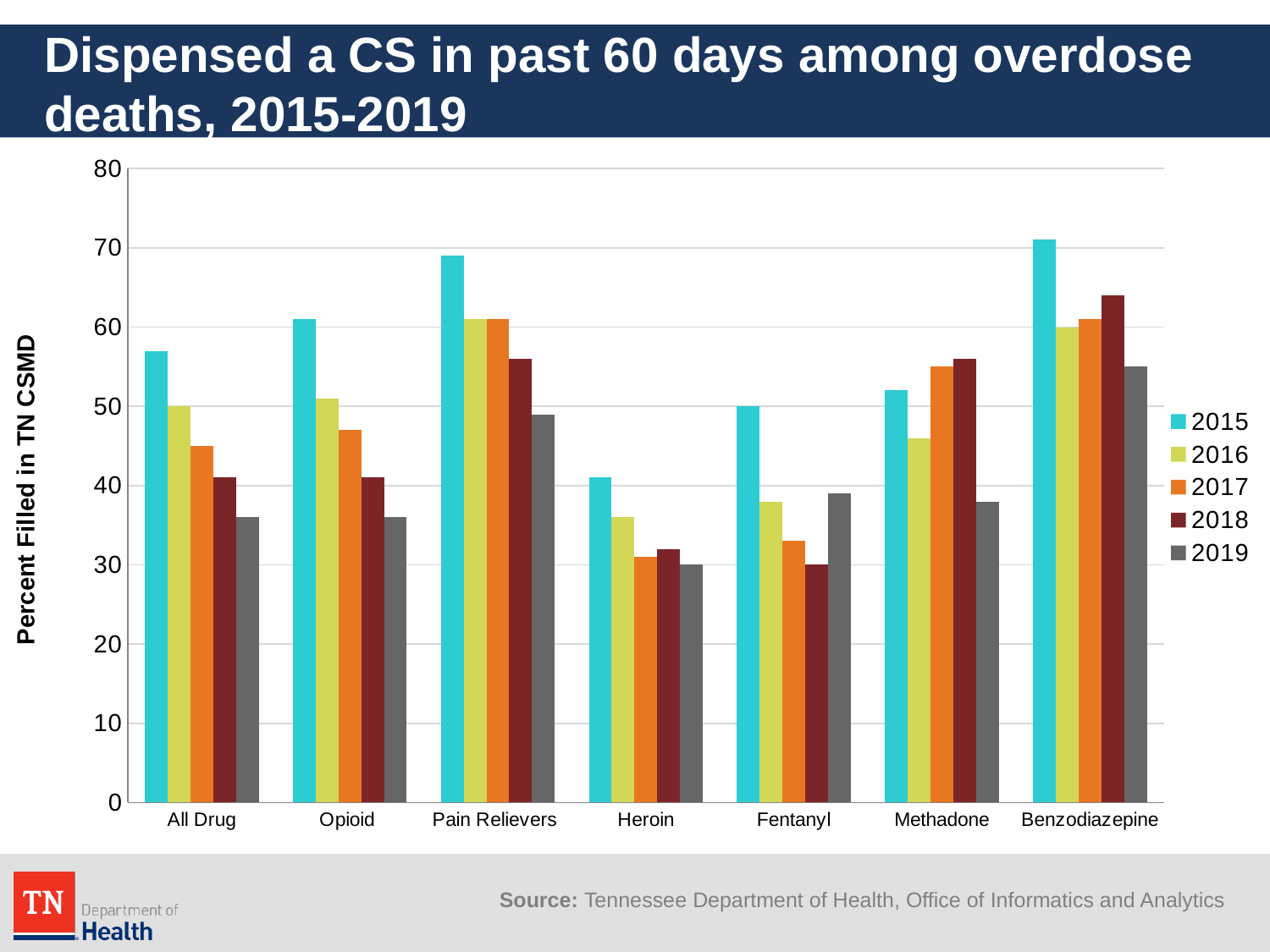
What is the title of the y axis? Percent Filled in TN CSMD For Fentanyl, which is larger: the 2019 value or the 2018 value? 2019 Which category has the lowest value for 2019? Heroin Is the 2017 value for Heroin greater or less than 40? less Which category has the highest value for 2019? Benzodiazepine Do the values for All Drug rise or fall from 2015 to 2019? fall Is the 2015 value for Pain Relievers greater or less than 60? greater How many drug categories are shown on the x axis? 7 Is the 2015 value for All Drug greater or less than 50? greater Which category has the lowest value for 2015? Heroin What kind of chart is shown on the slide? bar chart How many series does the legend list? 5